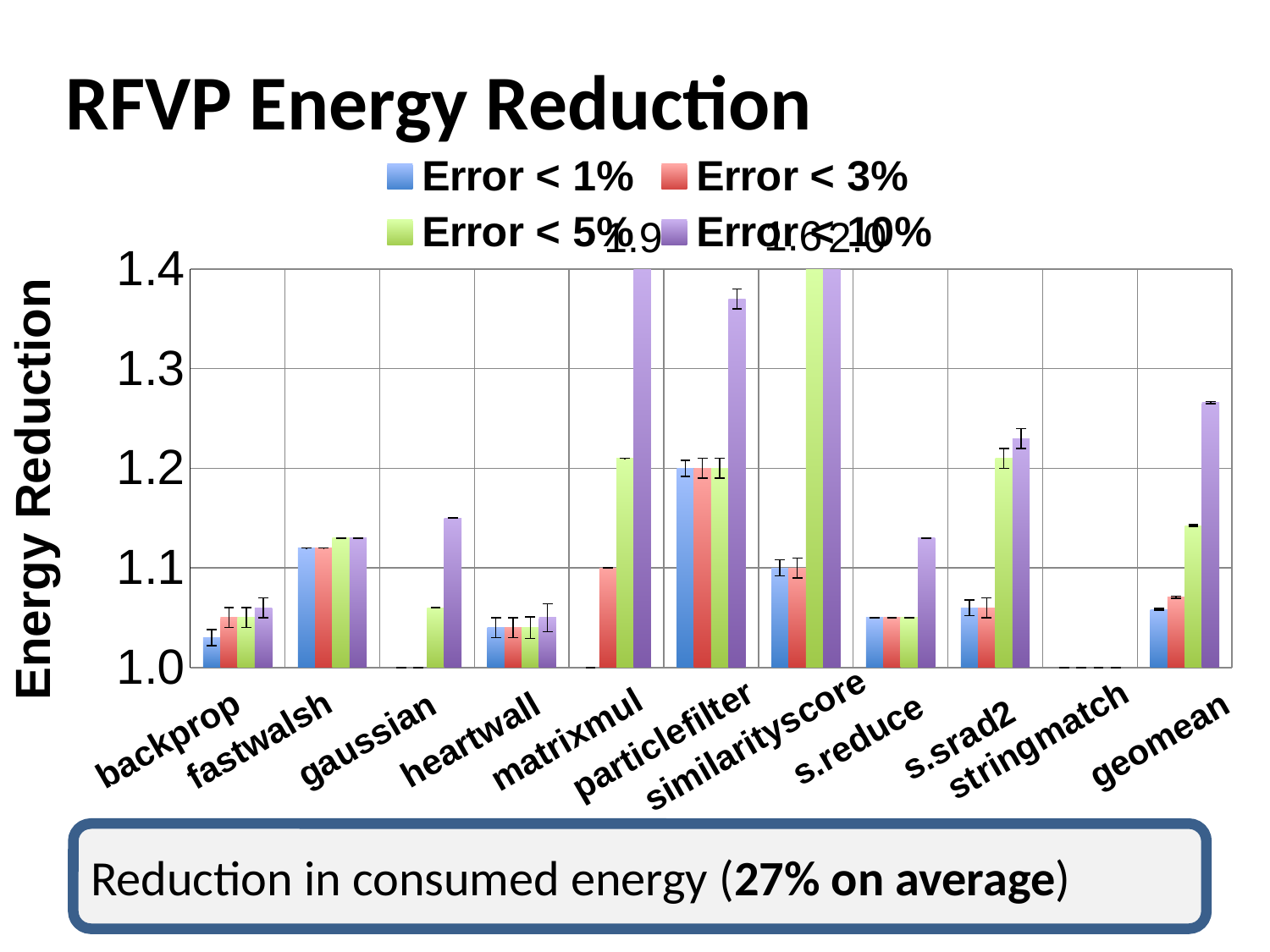
Is the Error < 1% value for s.reduce greater or less than 1.1? less How many categories are shown along the x axis of the chart? 11 How many series does the chart's legend list? 4 What is the label of the y axis? Energy Reduction Is the Error < 10% value for particlefilter greater or less than 1.3? greater What value is printed above the Error < 10% bar for matrixmul? 1.9 Which category has the highest Error < 1% bar? particlefilter What is the title of the chart? RFVP Energy Reduction What kind of chart is shown on the slide? bar chart Is the Error < 10% value for geomean greater or less than 1.2? greater Which is larger, the Error < 1% value for backprop or the Error < 1% value for fastwalsh? fastwalsh Which category has the lowest Error < 10% bar? stringmatch